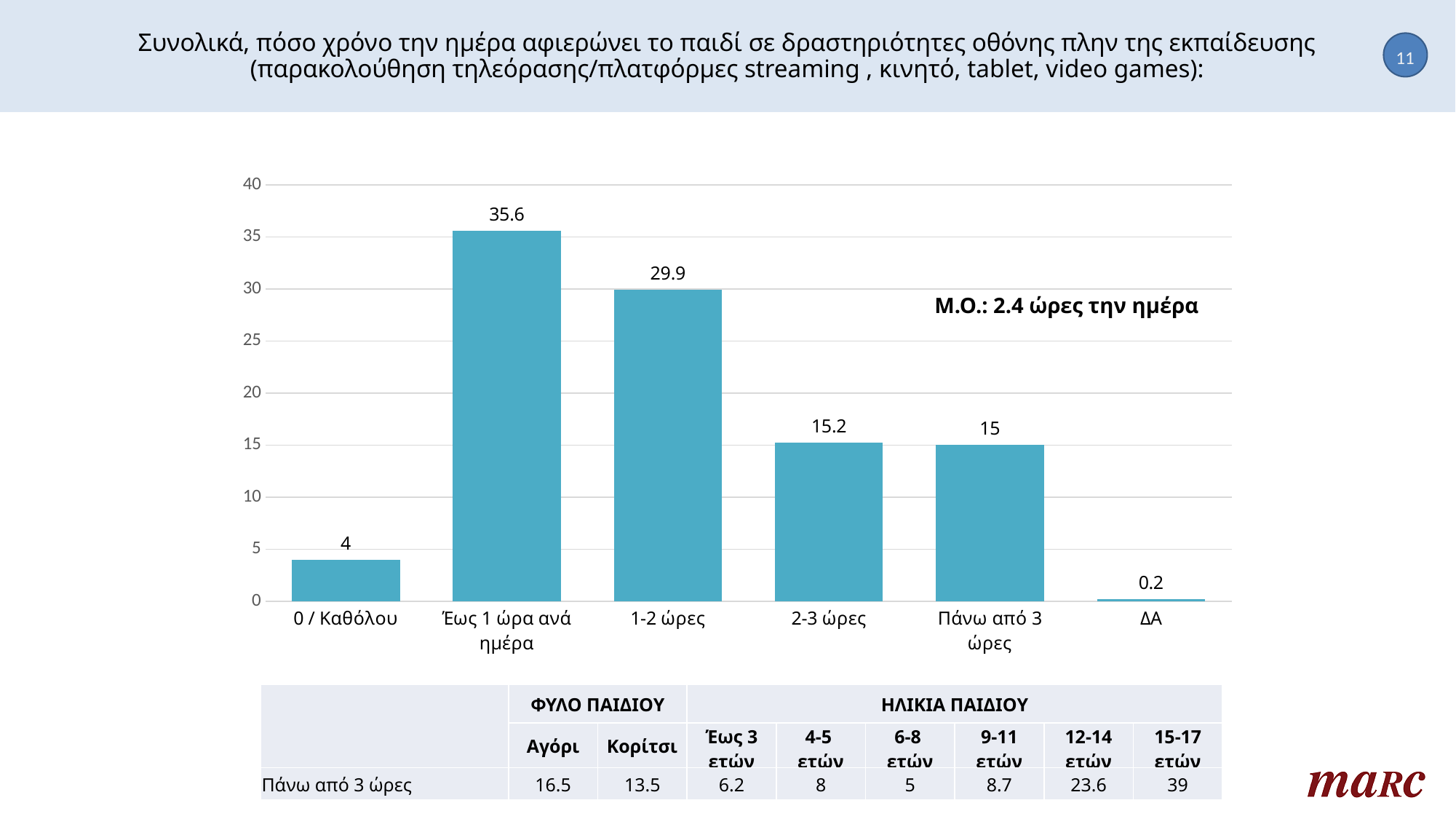
What is the value for the category '0 / Καθόλου'? 4 What is the value for the category 'Έως 1 ώρα ανά ημέρα'? 35.6 What is the difference between the values for 'Έως 1 ώρα ανά ημέρα' and '1-2 ώρες'? 5.7 What is the value for the category '1-2 ώρες'? 29.9 Which category has the highest value? Έως 1 ώρα ανά ημέρα What average (Μ.Ο.) is stated in the text inside the chart area? 2.4 ώρες την ημέρα Which category has the lowest value? ΔΑ What kind of chart is shown on the slide? bar chart How many categories are shown on the x axis of the chart? 6 What is the value for the category 'ΔΑ'? 0.2 Is the value for '2-3 ώρες' greater or less than 20? less Which is larger, the value for '1-2 ώρες' or the value for '2-3 ώρες'? 1-2 ώρες